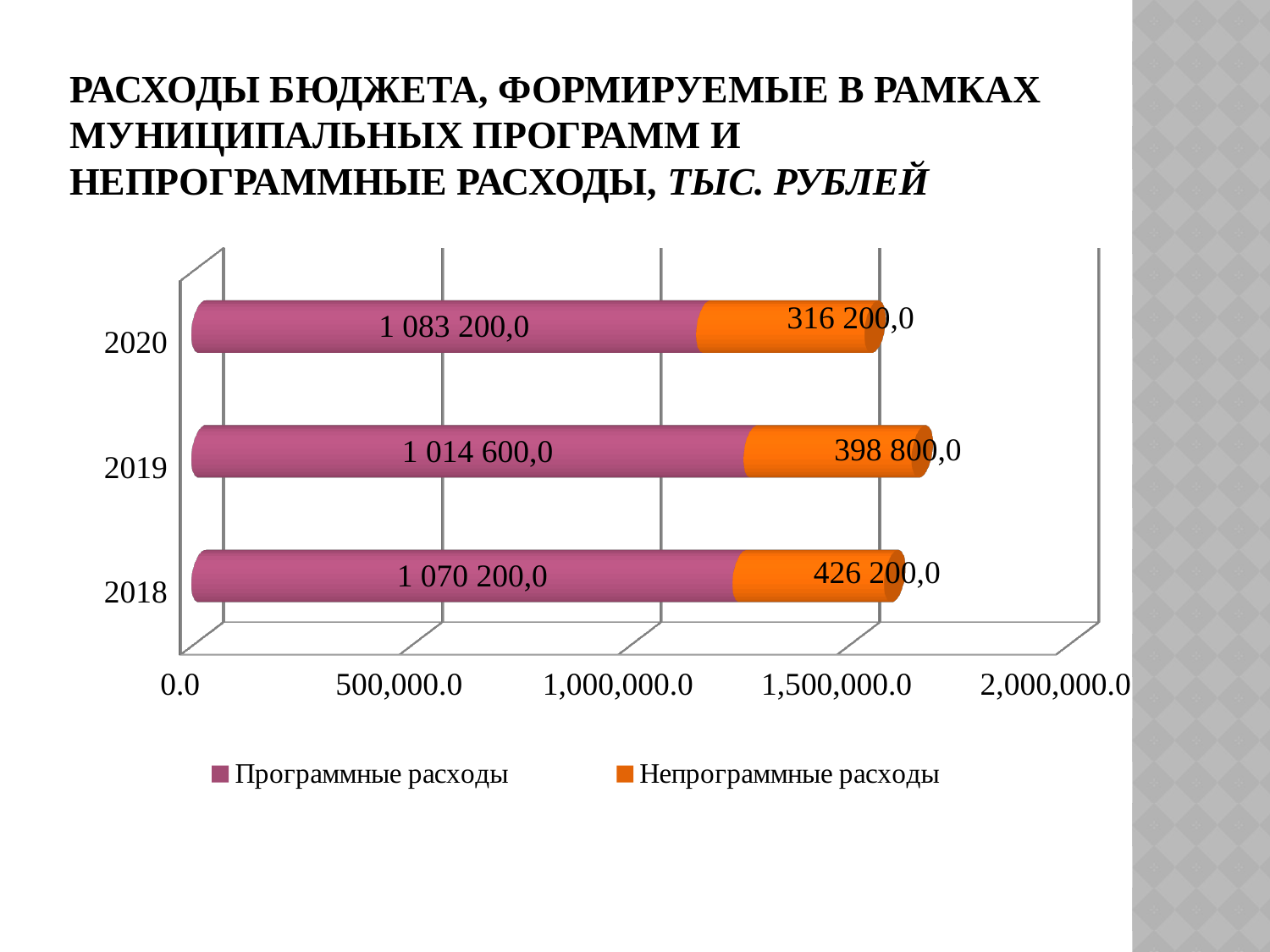
What is the value of Непрограммные расходы for 2018? 426 200,0 Which colour represents Непрограммные расходы in the legend? Orange What is the value of Непрограммные расходы for 2019? 398 800,0 How many years are shown on the chart? 3 What kind of chart is shown on the slide? Stacked bar chart Which year has the highest value of Программные расходы? 2020 How many series does the legend list? 2 What is the value of Программные расходы for 2020? 1 083 200,0 Which is larger: Непрограммные расходы in 2018 or in 2019? 2018 Which year has the lowest value of Непрограммные расходы? 2020 What is the difference between Программные расходы in 2020 and in 2019? 68 600,0 What is the total of the stacked bar for 2018? 1 496 400,0